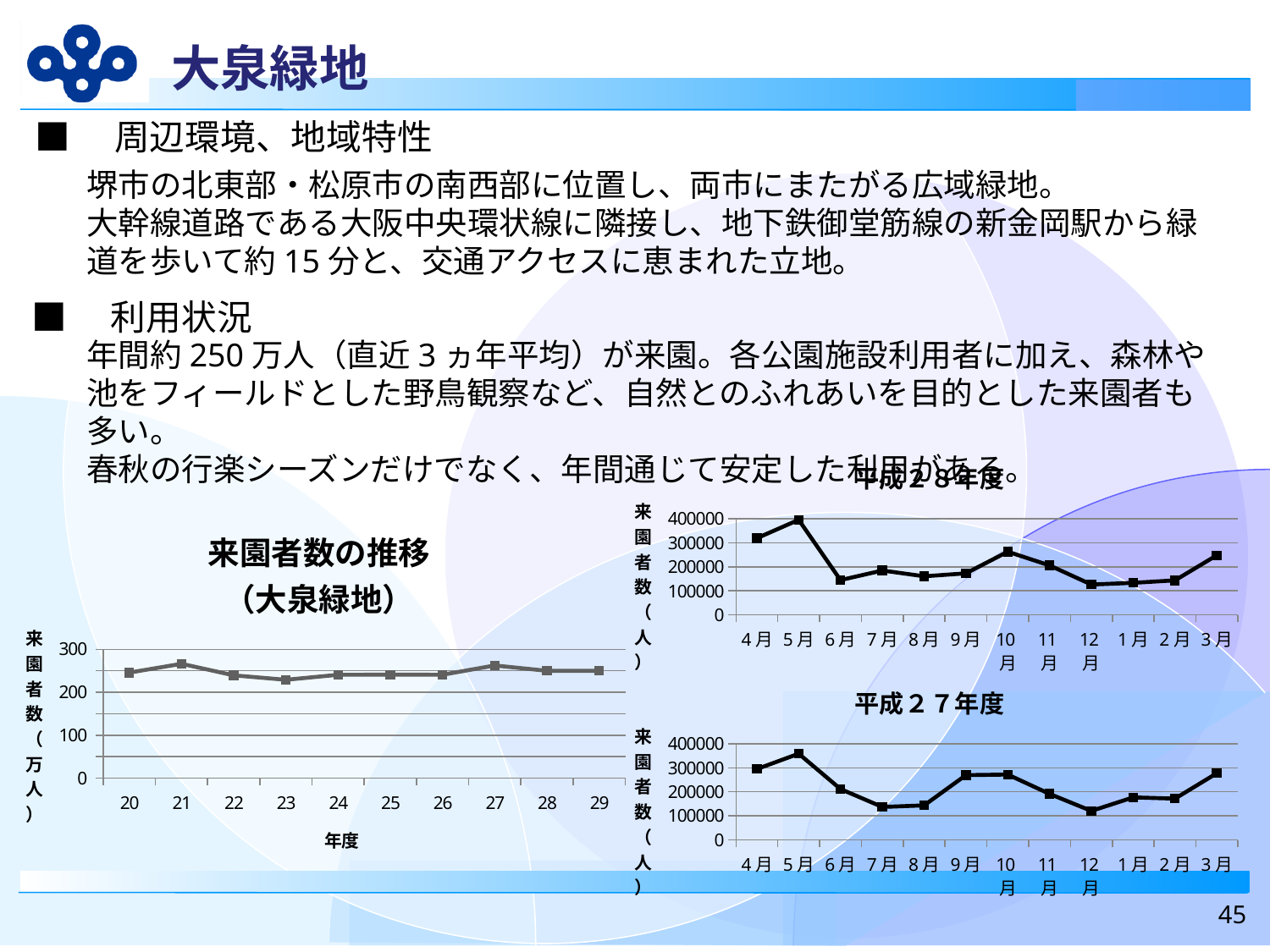
On the 平成２８年度 chart, which month has the highest number of visitors? 5月 On the 平成２８年度 chart, is the value for 6月 greater or less than 200000? less On the 平成２７年度 chart, which month has the lowest number of visitors? 12月 On the 平成２７年度 chart, which month has the highest number of visitors? 5月 On the 平成２７年度 chart, is the value for 7月 greater or less than 200000? less How many months are plotted on the 平成２７年度 chart? 12 What kind of chart is the 来園者数の推移（大泉緑地） chart on the left? line chart On the 平成２８年度 chart, which is larger, the value for 5月 or the value for 6月? 5月 On the 来園者数の推移（大泉緑地） chart, is the value for 23 greater or less than 200? greater How many years (data points) are plotted on the 来園者数の推移（大泉緑地） chart? 10